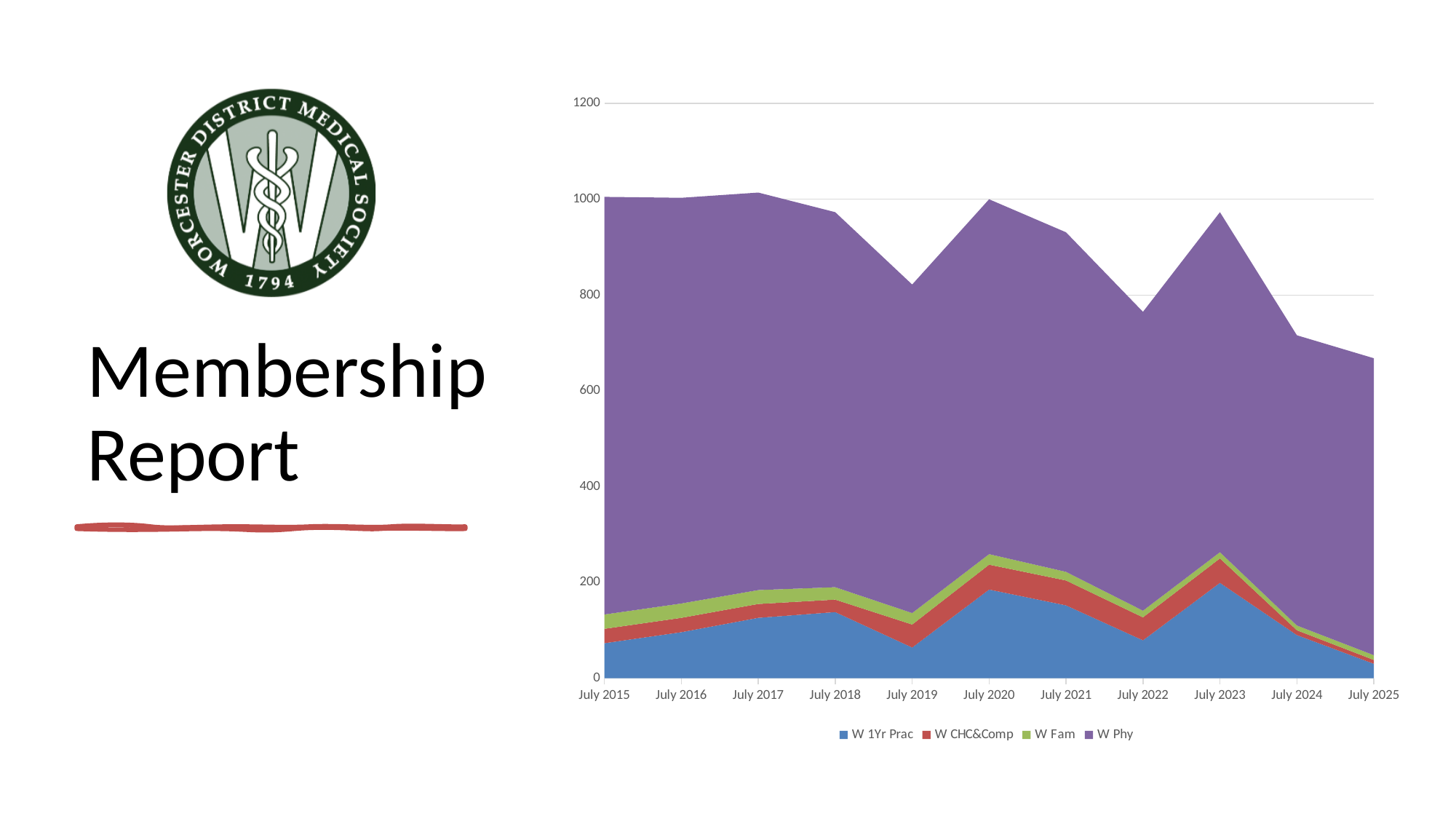
What kind of chart is shown on the slide? Stacked area chart Which has the larger total membership, July 2020 or July 2022? July 2020 Is the total membership for July 2023 greater or less than 800? greater How many series does the legend list? 4 Is the total membership for July 2022 greater or less than 800? less How many time points are shown along the x axis? 11 Is the value for W 1Yr Prac in July 2019 greater or less than 100? less Which time point has the lowest total membership? July 2025 What colour is the W Phy series? Purple Does total membership rise or fall overall from July 2015 to July 2025? Fall Which series is listed last in the legend? W Phy